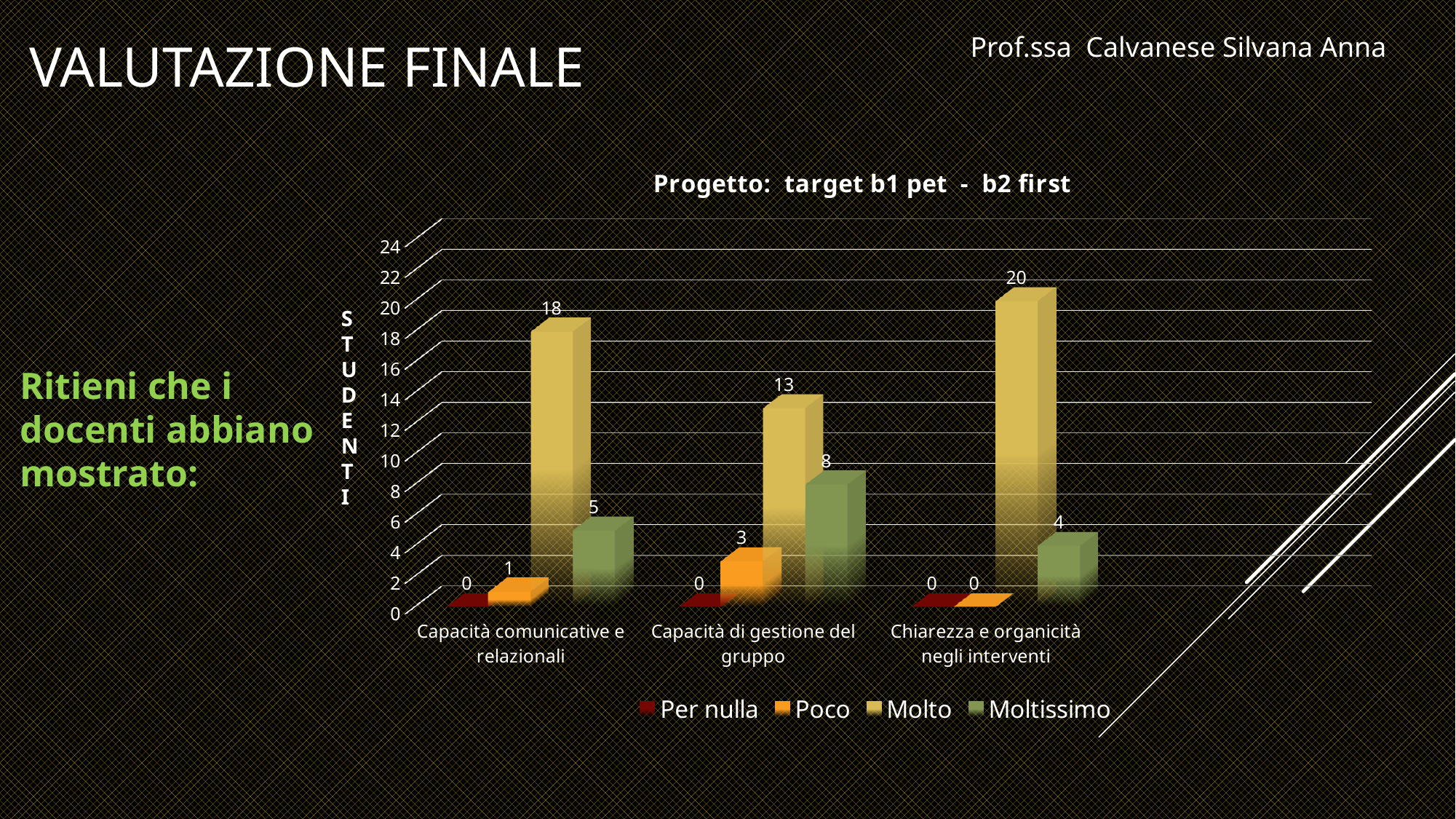
What is the value for "Moltissimo" in the "Capacità di gestione del gruppo" category? 8 In which category does the "Moltissimo" series have its lowest value? Chiarezza e organicità negli interventi What is the value for "Poco" in the "Capacità di gestione del gruppo" category? 3 What kind of chart is shown on the slide? Bar chart What is the title of the chart? Progetto: target b1 pet - b2 first In which category does the "Molto" series reach its highest value? Chiarezza e organicità negli interventi What is the value for "Molto" in the "Chiarezza e organicità negli interventi" category? 20 What is the value for "Molto" in the "Capacità comunicative e relazionali" category? 18 How many categories are shown on the x axis of the chart? 3 How many series does the chart legend list? 4 Which is larger: the "Moltissimo" value for "Capacità comunicative e relazionali" or for "Capacità di gestione del gruppo"? Capacità di gestione del gruppo What is the difference between the "Molto" values for "Chiarezza e organicità negli interventi" and "Capacità di gestione del gruppo"? 7